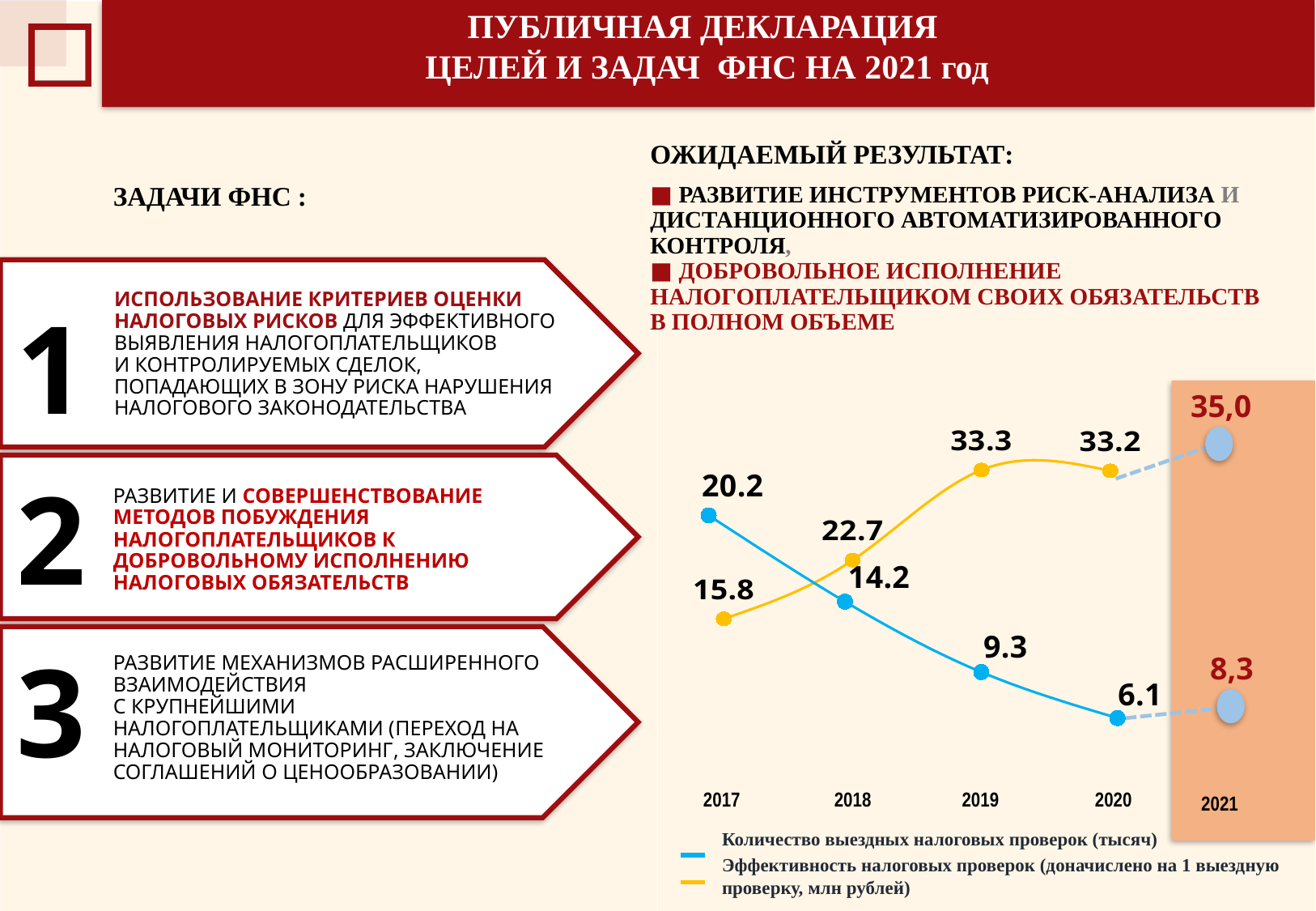
What is the projected value of 'Эффективность налоговых проверок' for 2021? 35,0 In which year is 'Эффективность налоговых проверок' highest? 2021 Does 'Количество выездных налоговых проверок (тысяч)' rise or fall from 2017 to 2020? fall How many years are shown on the x axis of the chart? 5 What kind of chart is shown on the slide? line chart What is the value of 'Эффективность налоговых проверок' in 2019? 33.3 How many series does the chart legend list? 2 Which is larger in 2018: 'Количество выездных налоговых проверок' or 'Эффективность налоговых проверок'? Эффективность налоговых проверок What is the value of 'Количество выездных налоговых проверок (тысяч)' in 2017? 20.2 What is the difference between the 'Количество выездных налоговых проверок' values for 2017 and 2018? 6.0 What is the value of 'Количество выездных налоговых проверок (тысяч)' in 2020? 6.1 In which year is 'Количество выездных налоговых проверок (тысяч)' lowest? 2020